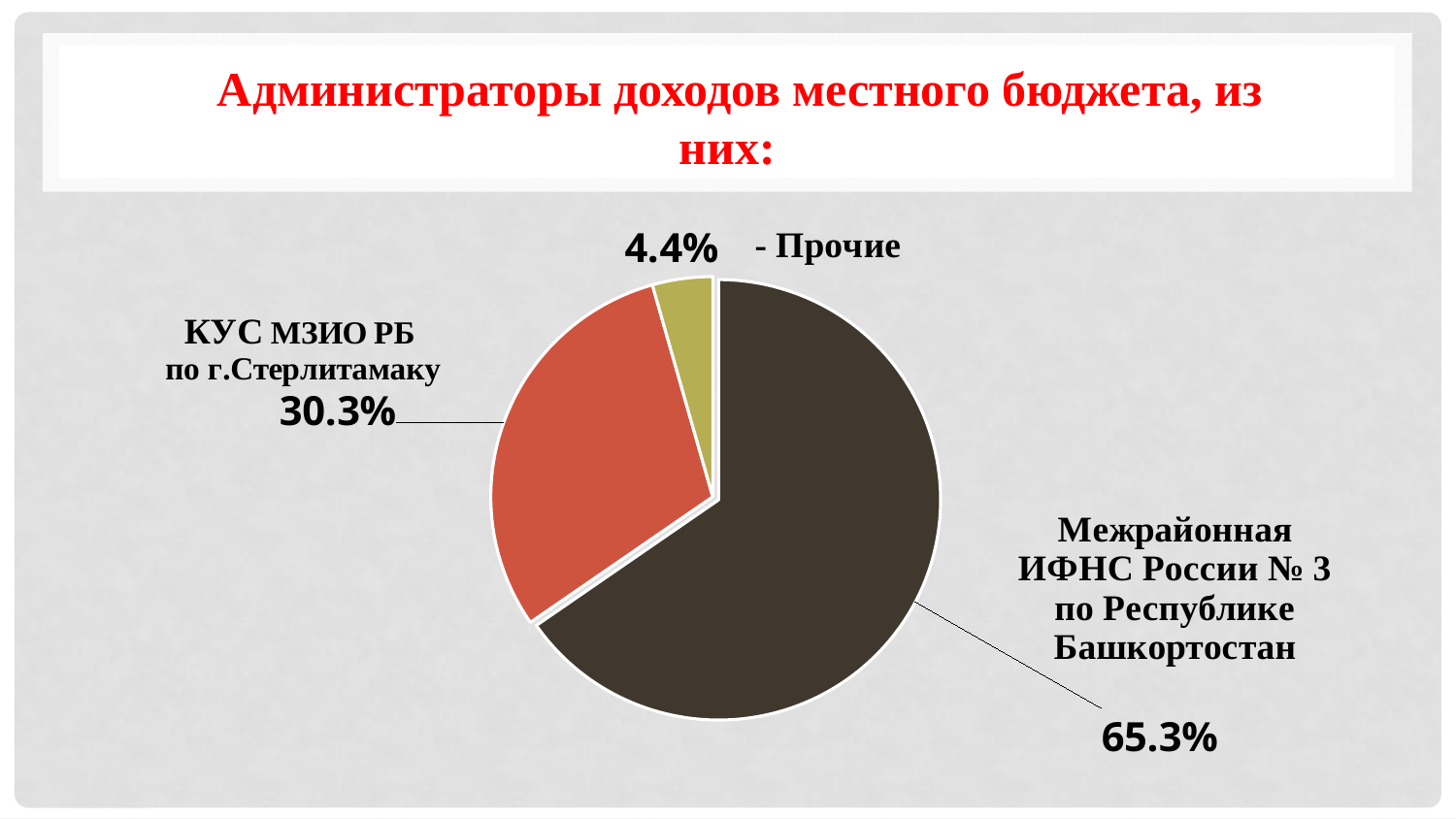
Which category has the largest slice of the pie? Межрайонная ИФНС России № 3 по Республике Башкортостан What share of the pie does КУС МЗИО РБ по г.Стерлитамаку have? 30.3% What share of the pie does Прочие have? 4.4% Which is larger: the share for КУС МЗИО РБ по г.Стерлитамаку or the share for Прочие? КУС МЗИО РБ по г.Стерлитамаку What is the title of the chart on the slide? Администраторы доходов местного бюджета, из них: What is the difference in percentage points between the КУС МЗИО РБ по г.Стерлитамаку slice and the Прочие slice? 25.9 percentage points What is the difference in percentage points between the Межрайонная ИФНС России № 3 slice and the КУС МЗИО РБ по г.Стерлитамаку slice? 35.0 percentage points What colour is the slice for Межрайонная ИФНС России № 3 по Республике Башкортостан? Dark brown What share of the pie does Межрайонная ИФНС России № 3 по Республике Башкортостан have? 65.3% Which category has the smallest slice of the pie? Прочие How many slices does the pie chart have? 3 What kind of chart is shown on the slide? Pie chart